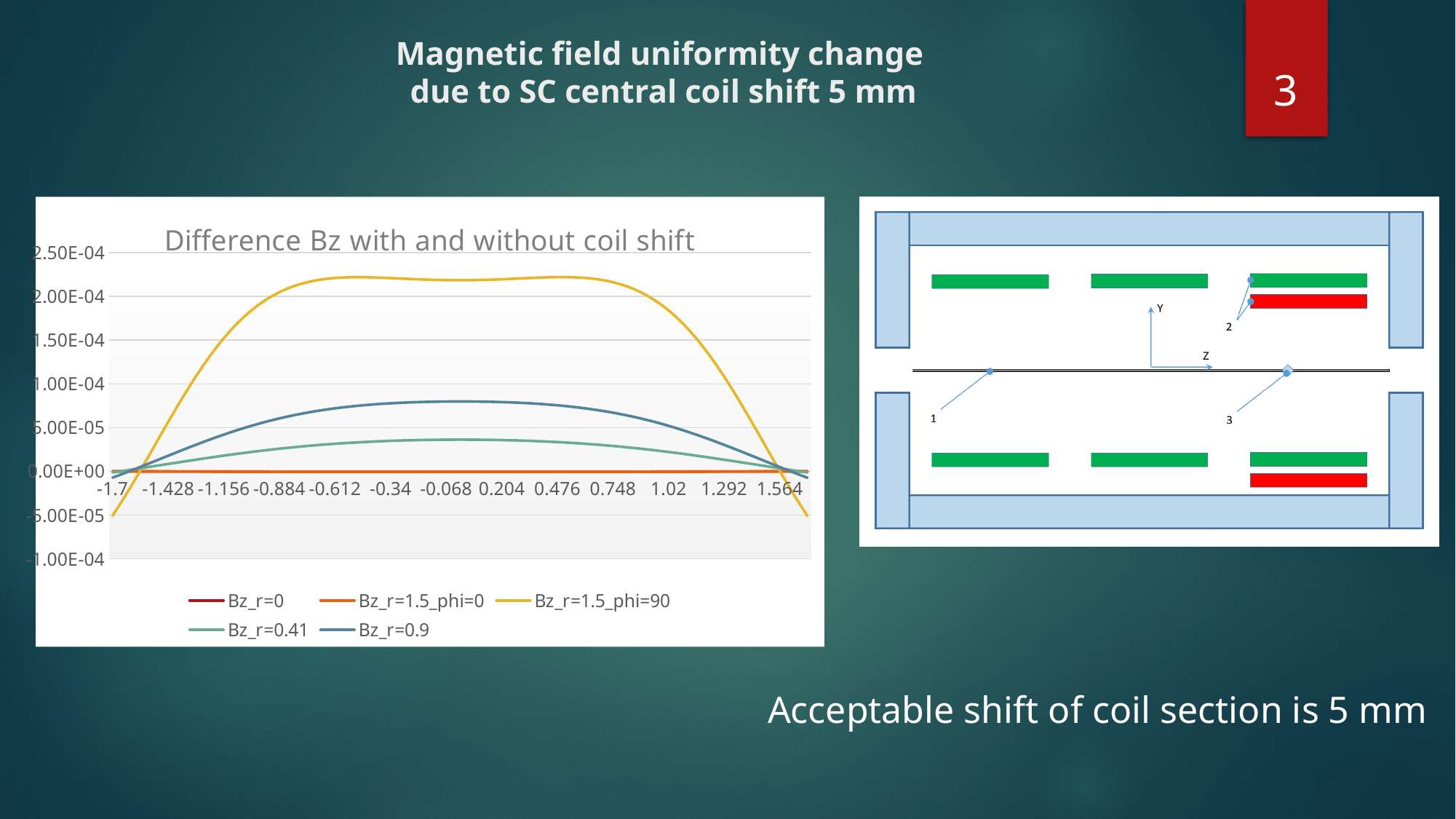
Which series reaches the highest value on the chart? Bz_r=1.5_phi=90 What colour is the Bz_r=1.5_phi=90 series drawn in? yellow How many tick labels are shown along the x axis of the chart? 13 Does the Bz_r=0.9 series rise or fall between x = 0.748 and x = 1.564? fall What kind of chart is shown on the slide? line chart Is the peak value of the Bz_r=1.5_phi=90 series greater or less than 2.00E-04? greater At x = 0.204, which series has the larger value: Bz_r=0.9 or Bz_r=0.41? Bz_r=0.9 Is the peak value of the Bz_r=0.41 series greater or less than 5.00E-05? less What is the title of the chart? Difference Bz with and without coil shift Is the peak value of the Bz_r=0.9 series greater or less than 1.00E-04? less Does the Bz_r=1.5_phi=90 series rise or fall between x = -1.7 and x = -0.612? rise How many series does the chart legend list? 5